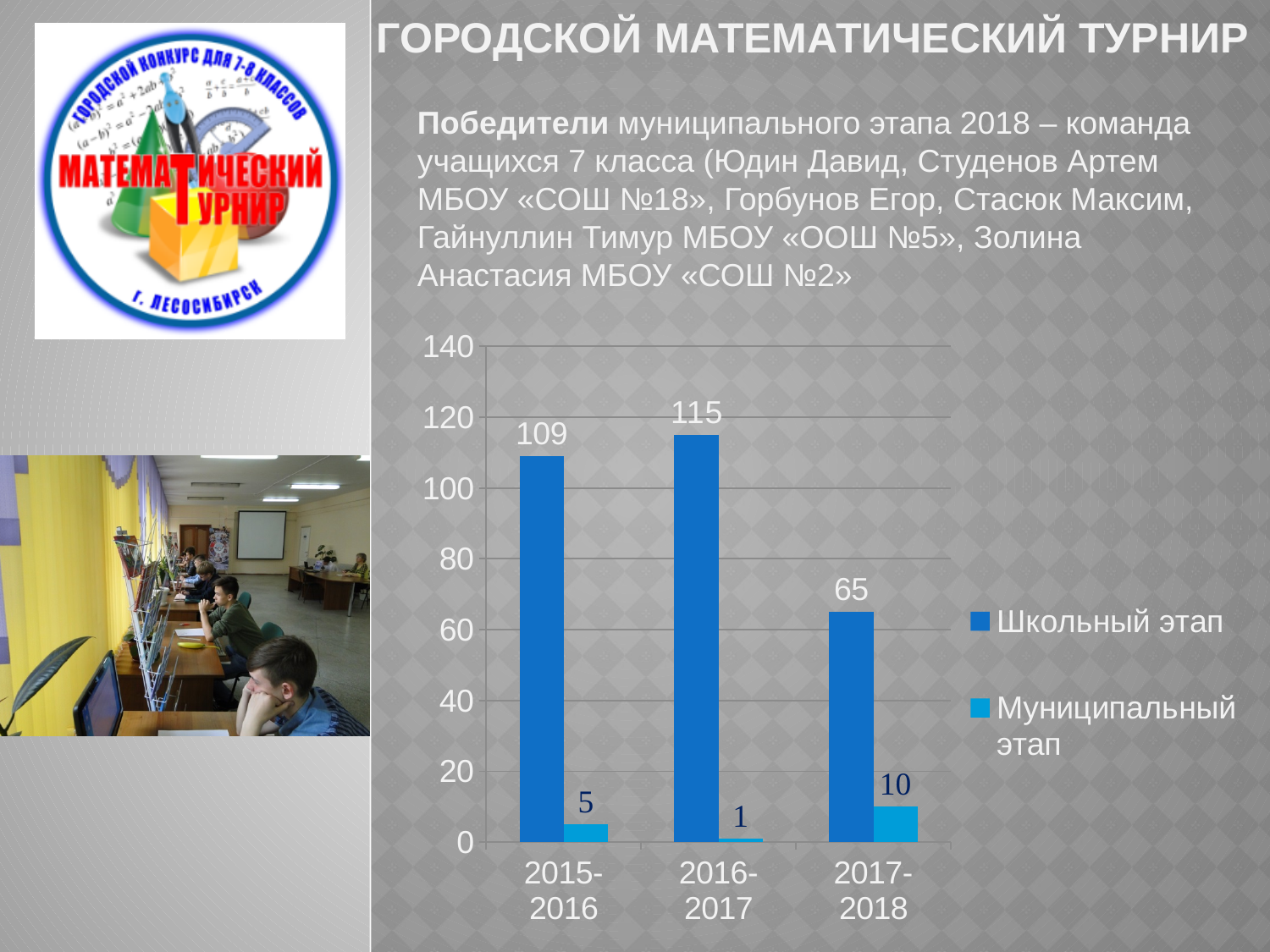
Which year has the highest value for Школьный этап? 2016-2017 What is the total of Школьный этап and Муниципальный этап for 2015-2016? 114 How many year categories are shown on the x axis? 3 What is the value for Муниципальный этап in 2017-2018? 10 What is the difference between the Школьный этап values for 2016-2017 and 2017-2018? 50 Which is larger: Муниципальный этап in 2015-2016 or in 2017-2018? 2017-2018 What kind of chart is shown on the slide? bar chart Which year has the lowest value for Муниципальный этап? 2016-2017 Is the value for Школьный этап in 2017-2018 greater or less than 80? less What is the value for Школьный этап in 2015-2016? 109 How many series does the legend list? 2 What is the value for Школьный этап in 2016-2017? 115